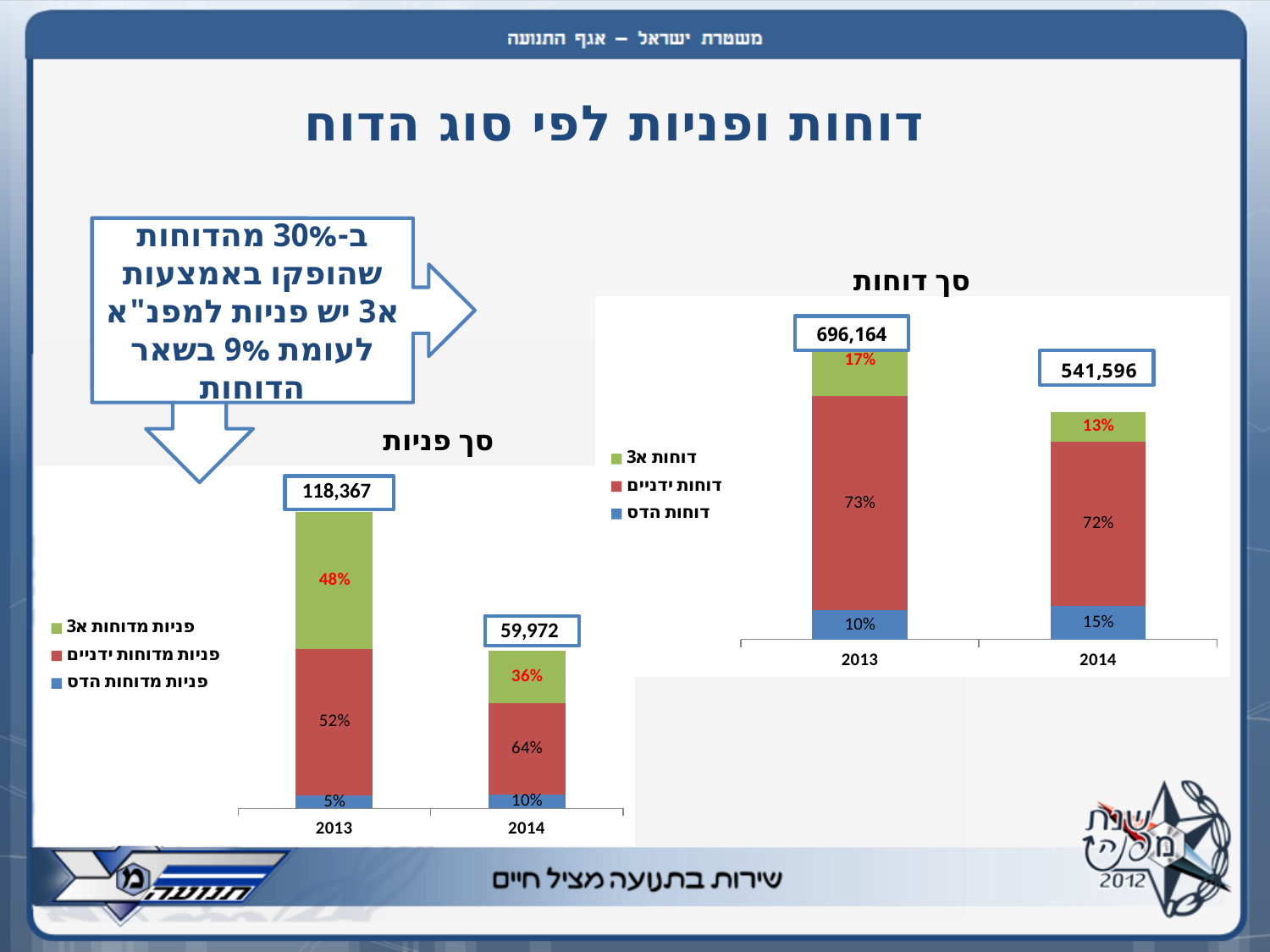
In the chart titled סך דוחות, what is the total value shown above the 2014 bar? 541,596 In the chart titled סך פניות, what percentage does the פניות מדוחות א3 segment show for 2014? 36% In the chart titled סך דוחות, what percentage does the דוחות הדס segment show for 2013? 10% In the chart titled סך דוחות, what is the difference between the 2013 and 2014 totals? 154,568 In the chart titled סך פניות, what percentage does the פניות מדוחות ידניים segment show for 2013? 52% In the chart titled סך דוחות, what is the total value shown above the 2013 bar? 696,164 In the chart titled סך דוחות, what percentage does the דוחות א3 segment show for 2014? 13% In the chart titled סך פניות, how many series does the legend list? 3 What kind of chart is the chart titled סך דוחות? Stacked bar chart In the chart titled סך פניות, what is the total value shown above the 2013 bar? 118,367 In the chart titled סך פניות, which year has the higher total, 2013 or 2014? 2013 In the chart titled סך דוחות, which colour represents דוחות ידניים? Red